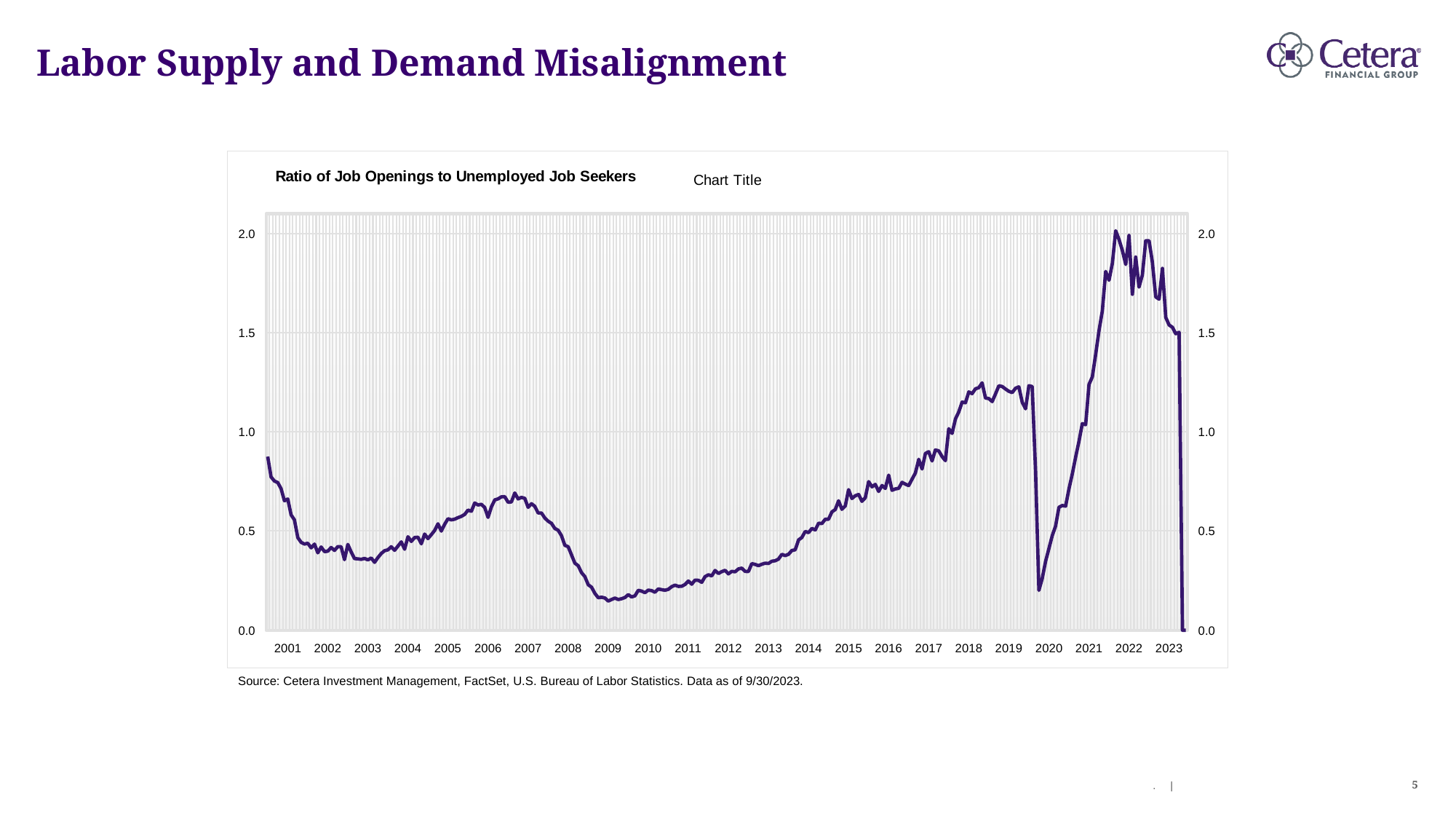
Which is higher, the ratio in 2019 or the ratio in 2009? 2019 How many year labels are shown on the x axis? 23 Is the value of the ratio in 2019 greater or less than 1.0? greater Which is higher, the ratio in 2007 or the ratio in 2003? 2007 Is the value of the ratio in 2003 greater or less than 0.5? less What kind of chart is shown on the slide? Line chart Is the value of the ratio in 2016 greater or less than 1.0? less Does the ratio rise or fall between 2009 and 2019? rise What is the title of the chart? Ratio of Job Openings to Unemployed Job Seekers Does the ratio rise or fall between 2007 and 2009? fall